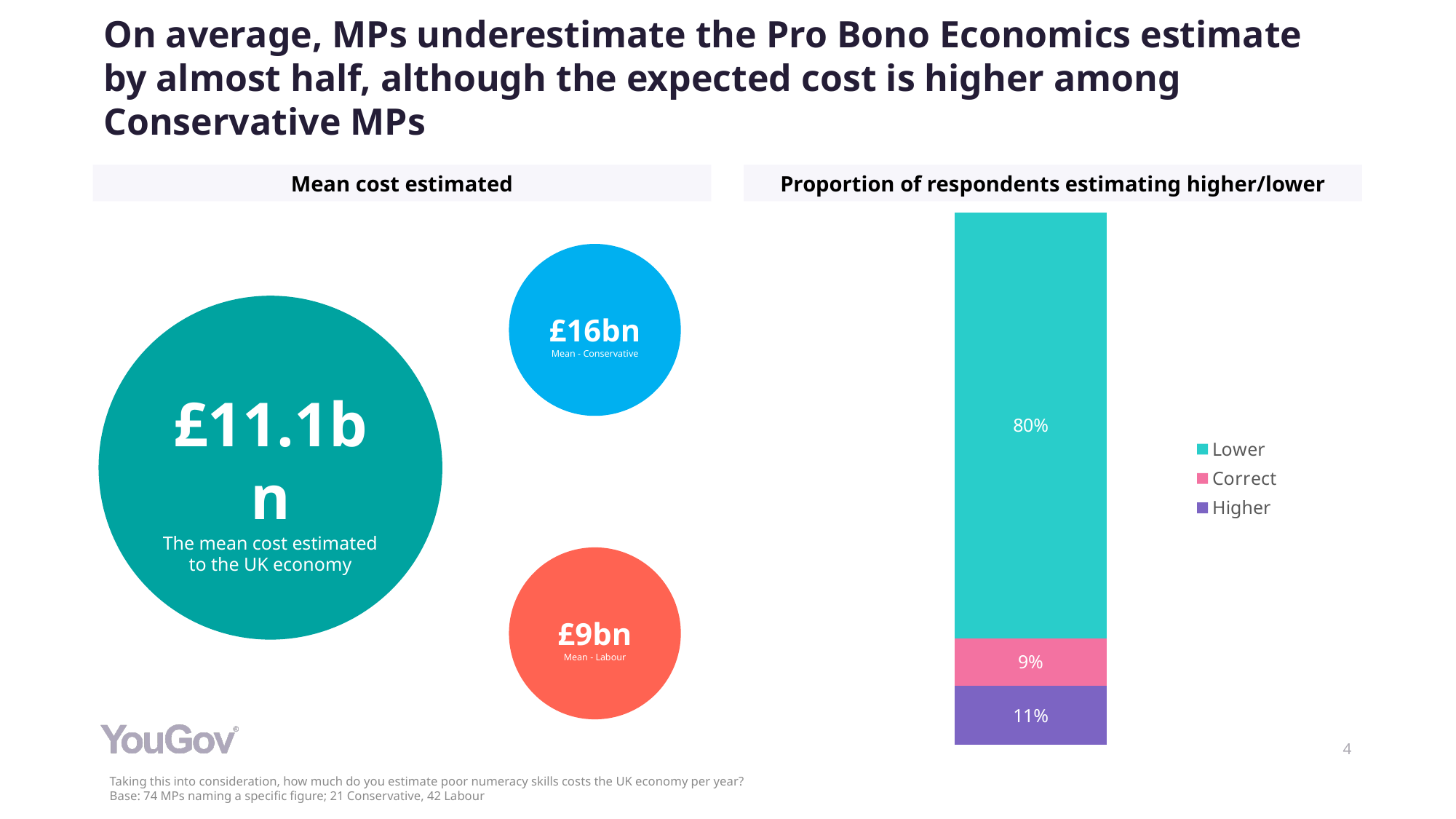
In the 'Proportion of respondents estimating higher/lower' chart, what is the total of the stacked bar? 100% In the 'Proportion of respondents estimating higher/lower' chart, what percentage of respondents estimated correctly? 9% In the 'Proportion of respondents estimating higher/lower' chart, what percentage of respondents estimated higher? 11% In the 'Proportion of respondents estimating higher/lower' chart, what percentage of respondents estimated lower? 80% In the 'Mean cost estimated' section, what is the mean cost estimated by Conservative MPs? £16bn In the 'Proportion of respondents estimating higher/lower' chart, what is the difference in percentage points between the Lower and Higher segments? 69 In the 'Proportion of respondents estimating higher/lower' chart, which segment is the largest? Lower In the 'Mean cost estimated' section, what is the mean cost estimated by Labour MPs? £9bn In the 'Proportion of respondents estimating higher/lower' chart, which is larger: the Higher segment or the Correct segment? Higher In the 'Proportion of respondents estimating higher/lower' chart, which segment is the smallest? Correct How many series does the legend of the 'Proportion of respondents estimating higher/lower' chart list? 3 What kind of chart is the 'Proportion of respondents estimating higher/lower' chart? Stacked bar chart